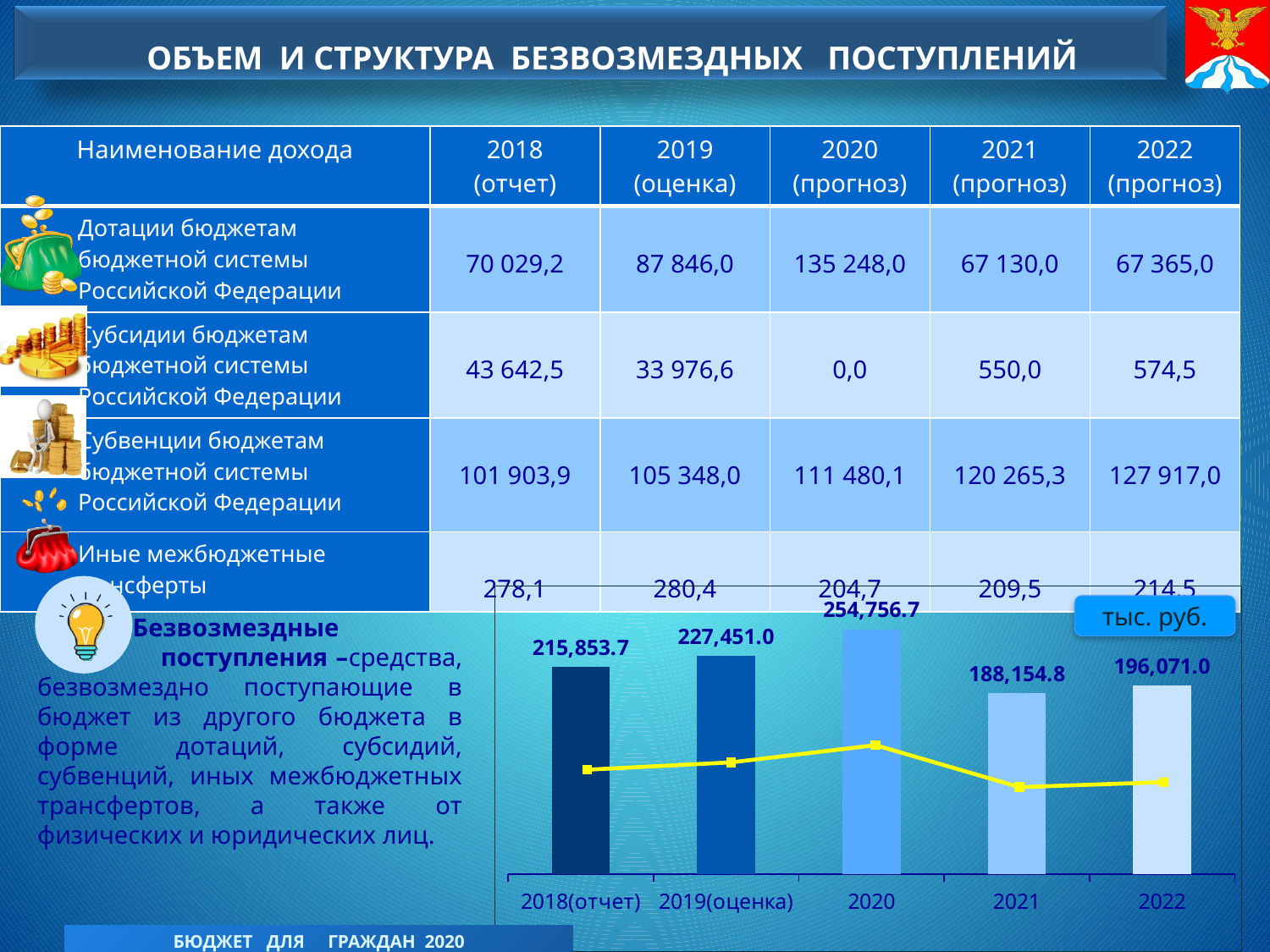
How many bars are plotted in the chart? 5 Do the bar values rise or fall from 2018(отчет) to 2020 in the chart? rise What is the difference between the bar values for 2019(оценка) and 2018(отчет) in the chart? 11,597.3 What unit is shown in the box next to the chart? тыс. руб. What is the value of the bar for 2020 in the chart at the bottom of the slide? 254,756.7 What is the value of the bar for 2022 in the chart? 196,071.0 What is the value of the bar for 2021 in the chart? 188,154.8 What is the difference between the bar values for 2020 and 2021 in the chart? 66,601.9 What is the value of the bar for 2018(отчет) in the chart? 215,853.7 Which bar is larger in the chart, 2022 or 2021? 2022 Which year has the highest bar in the chart? 2020 Which year has the lowest bar in the chart? 2021